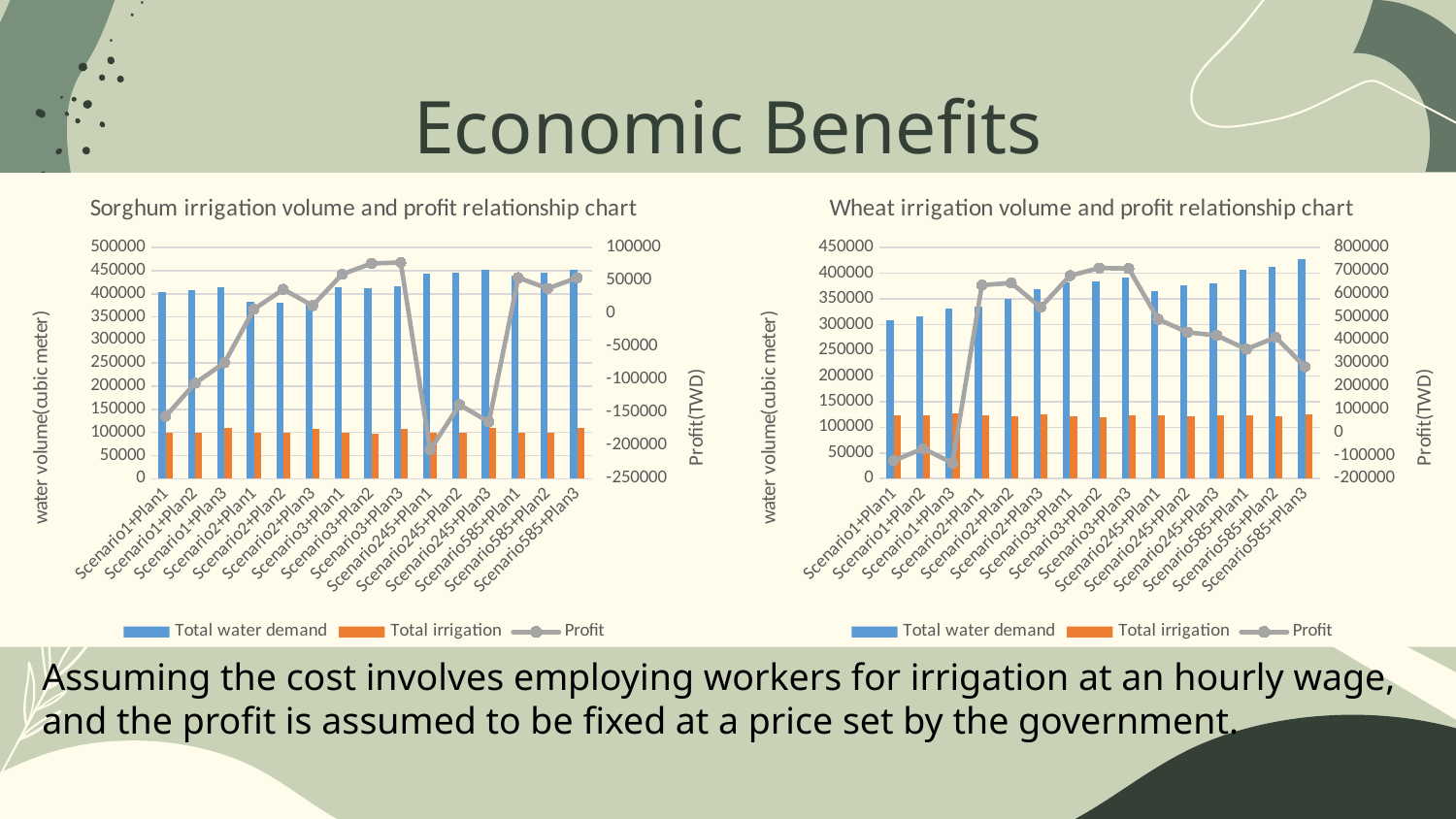
What is the label of the left vertical axis on the Sorghum irrigation volume and profit relationship chart? water volume(cubic meter) In the Wheat irrigation volume and profit relationship chart, is the Profit for Scenario585+Plan3 greater or less than 400000? less In the Wheat irrigation volume and profit relationship chart, which category has the highest Total water demand? Scenario585+Plan3 How many categories are shown on the x axis of the Sorghum irrigation volume and profit relationship chart? 15 In the Sorghum irrigation volume and profit relationship chart, which category has the lowest Profit? Scenario245+Plan1 What kind of chart is the Sorghum irrigation volume and profit relationship chart? A combination bar and line chart How many series does the legend of the Wheat irrigation volume and profit relationship chart list? 3 In the Wheat irrigation volume and profit relationship chart, is the Total water demand for Scenario585+Plan3 greater or less than 400000? greater In the Wheat irrigation volume and profit relationship chart, which is larger: the Total water demand for Scenario1+Plan1 or for Scenario585+Plan3? Scenario585+Plan3 In the Sorghum irrigation volume and profit relationship chart, is the Total water demand for Scenario1+Plan1 greater or less than 350000? greater In the Wheat irrigation volume and profit relationship chart, does the Profit generally rise or fall from Scenario245+Plan1 to Scenario585+Plan3? fall